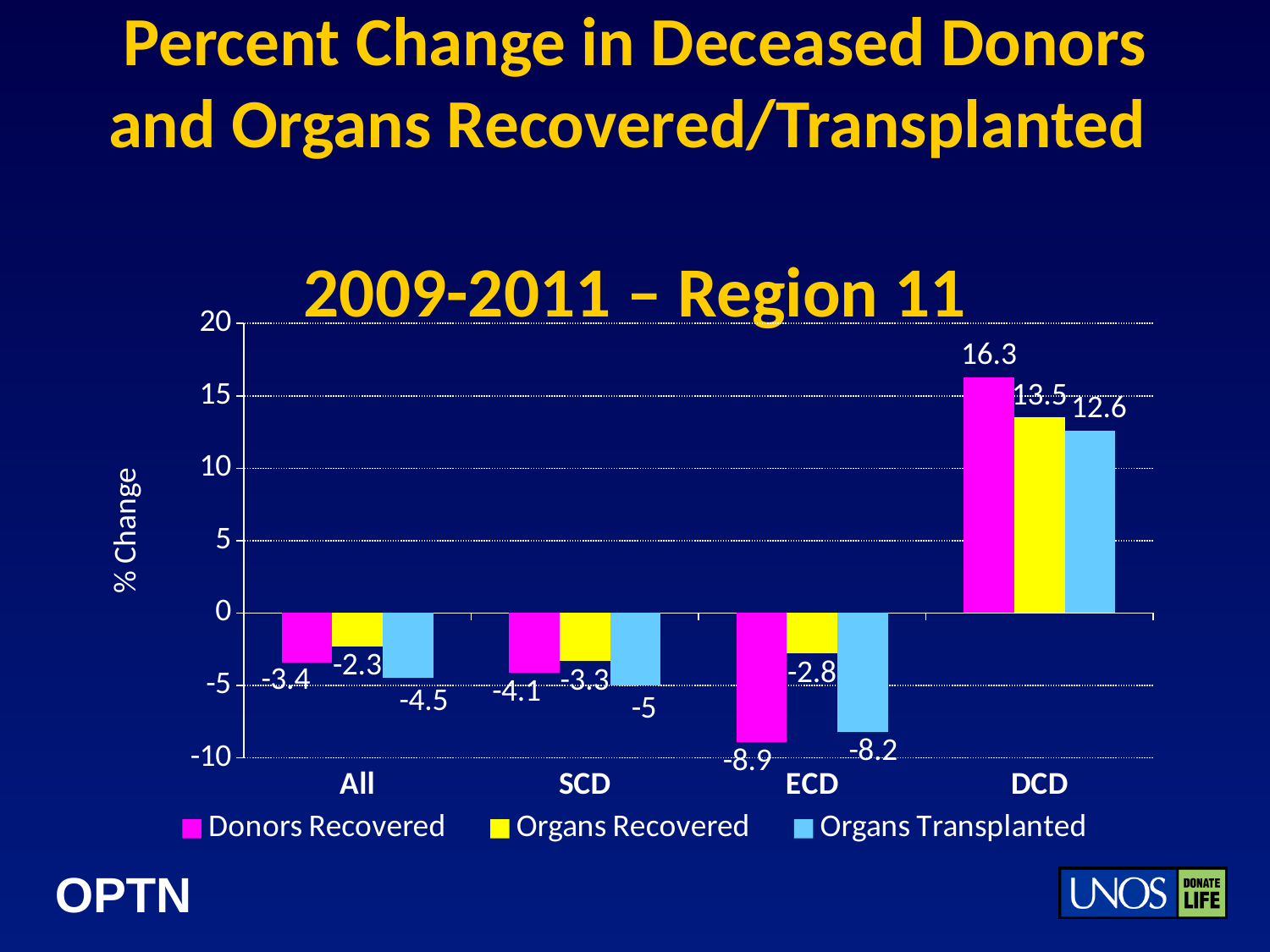
Which category has the lowest Donors Recovered value? ECD What kind of chart is shown on the slide? Bar chart What is the percent change in Organs Recovered for SCD? -3.3 What is the percent change in Organs Transplanted for ECD? -8.2 What is the difference between the Donors Recovered and Organs Transplanted values for DCD? 3.7 How many categories are shown on the x axis? 4 What is the label on the vertical axis? % Change What is the percent change in Organs Transplanted for All? -4.5 Which is larger for ECD: Organs Recovered or Organs Transplanted? Organs Recovered How many series does the legend list? 3 Which category has the highest Donors Recovered value? DCD What is the percent change in Donors Recovered for DCD? 16.3